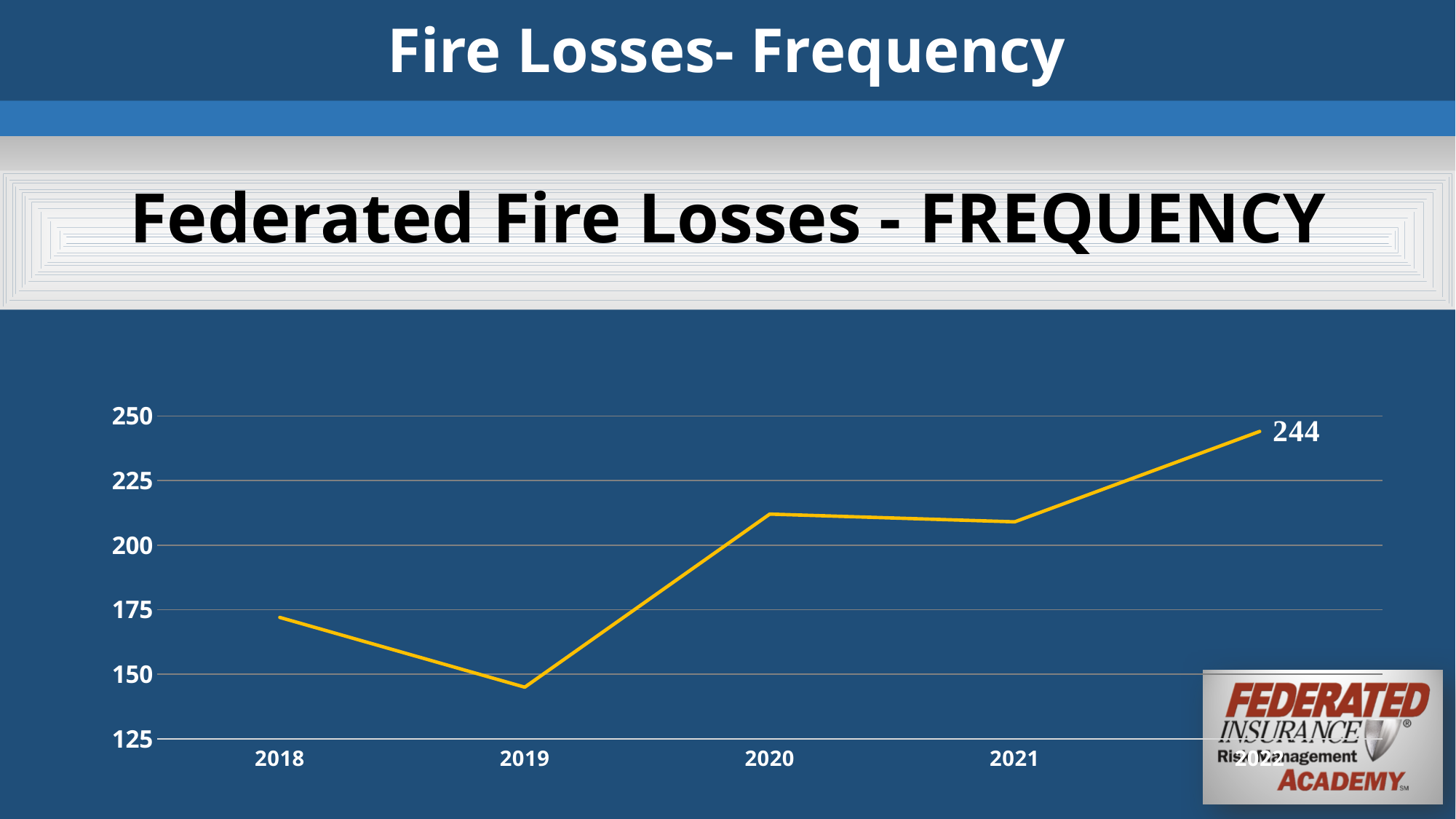
Is the value for 2018 greater or less than 150? greater Which year has the highest value? 2022 Which is larger, the value for 2019 or the value for 2020? 2020 Is the value for 2020 greater or less than 200? greater What is the value for 2022? 244 Is the value for 2019 greater or less than 150? less How many years are plotted on the x axis? 5 What kind of chart is shown? line chart Does the value rise or fall from 2021 to 2022? rise Does the value rise or fall from 2018 to 2019? fall Which year has the lowest value? 2019